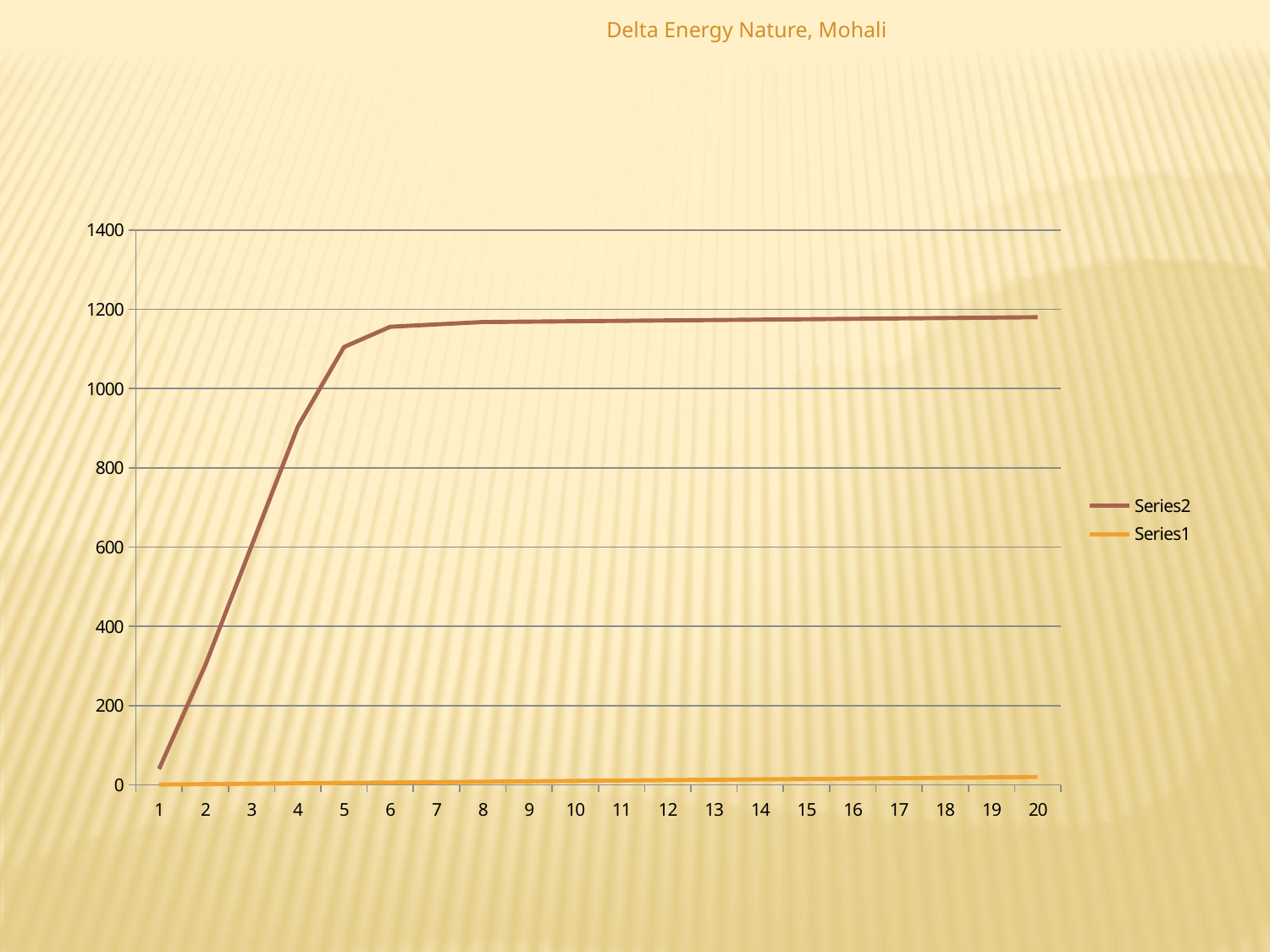
What kind of chart is shown on the slide? line chart Is the value of Series2 at x = 4 greater or less than 800? greater How many series does the legend list? 2 Does Series2 rise or fall from x = 1 to x = 5? rise At x = 10, which series has the larger value, Series1 or Series2? Series2 How many points are plotted along the x axis for each series? 20 Is the value of Series1 at x = 20 greater or less than 200? less At which x value does Series2 reach its lowest point? 1 What is the title shown at the top of the slide? Delta Energy Nature, Mohali Is the value of Series2 at x = 1 greater or less than 200? less Which series is drawn with the brown line? Series2